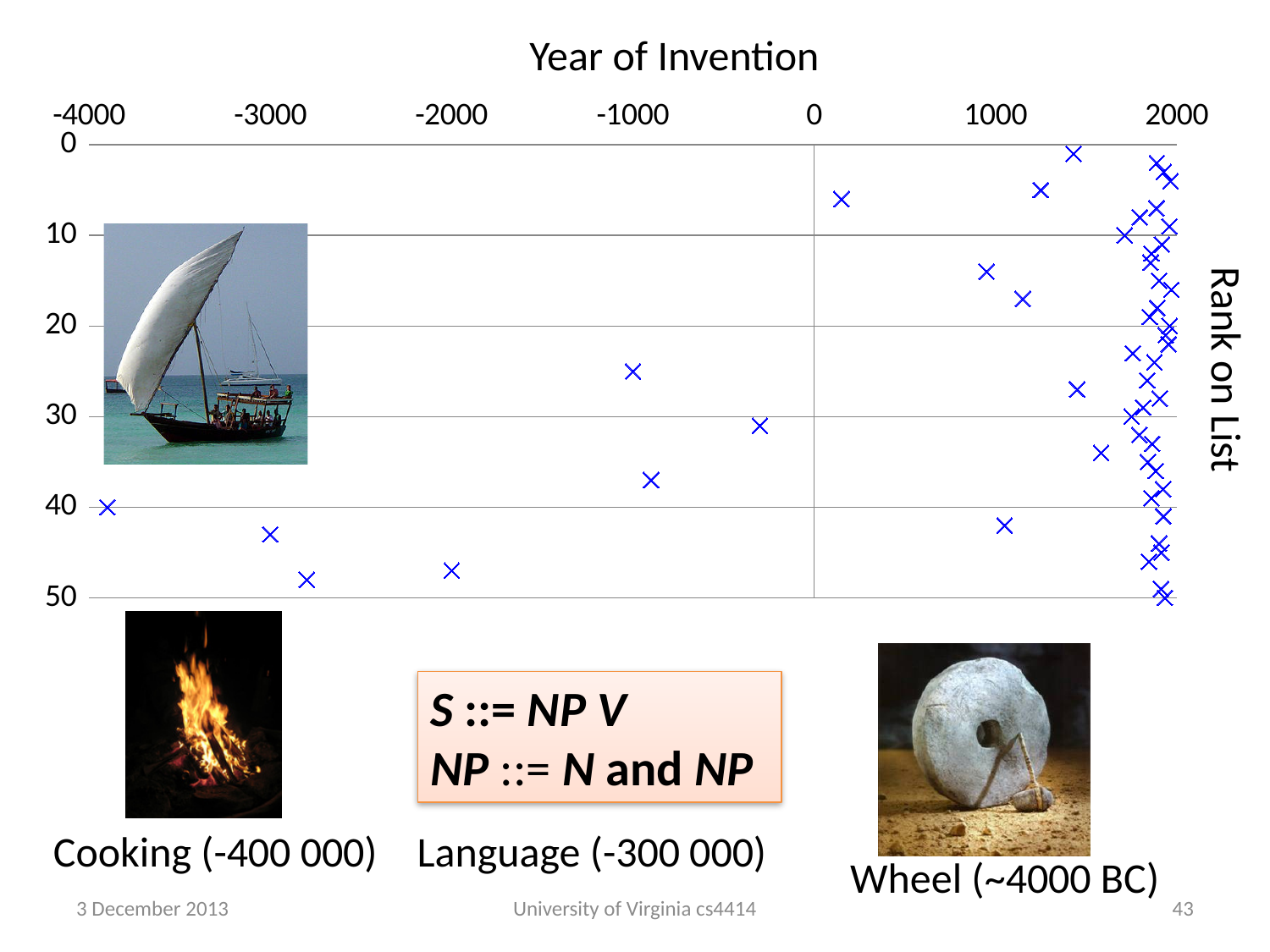
Is the year of invention for the point at rank 6 greater or less than 1000? less How many points are plotted with a year of invention before 0 (left of the 0 line)? 7 What is the title of the vertical axis of the chart? Rank on List Is the rank of the point at about year -2000 greater or less than 40? greater Is the rank of the point with the earliest year of invention (near -4000) greater or less than 30? greater Which point has the earlier year of invention: the one at rank 40 or the one at rank 25? the one at rank 40 Which point has the later year of invention: the one at rank 48 or the one at rank 47? the one at rank 47 What is the title of the horizontal axis of the chart? Year of Invention What kind of chart is shown on the slide? scatter chart